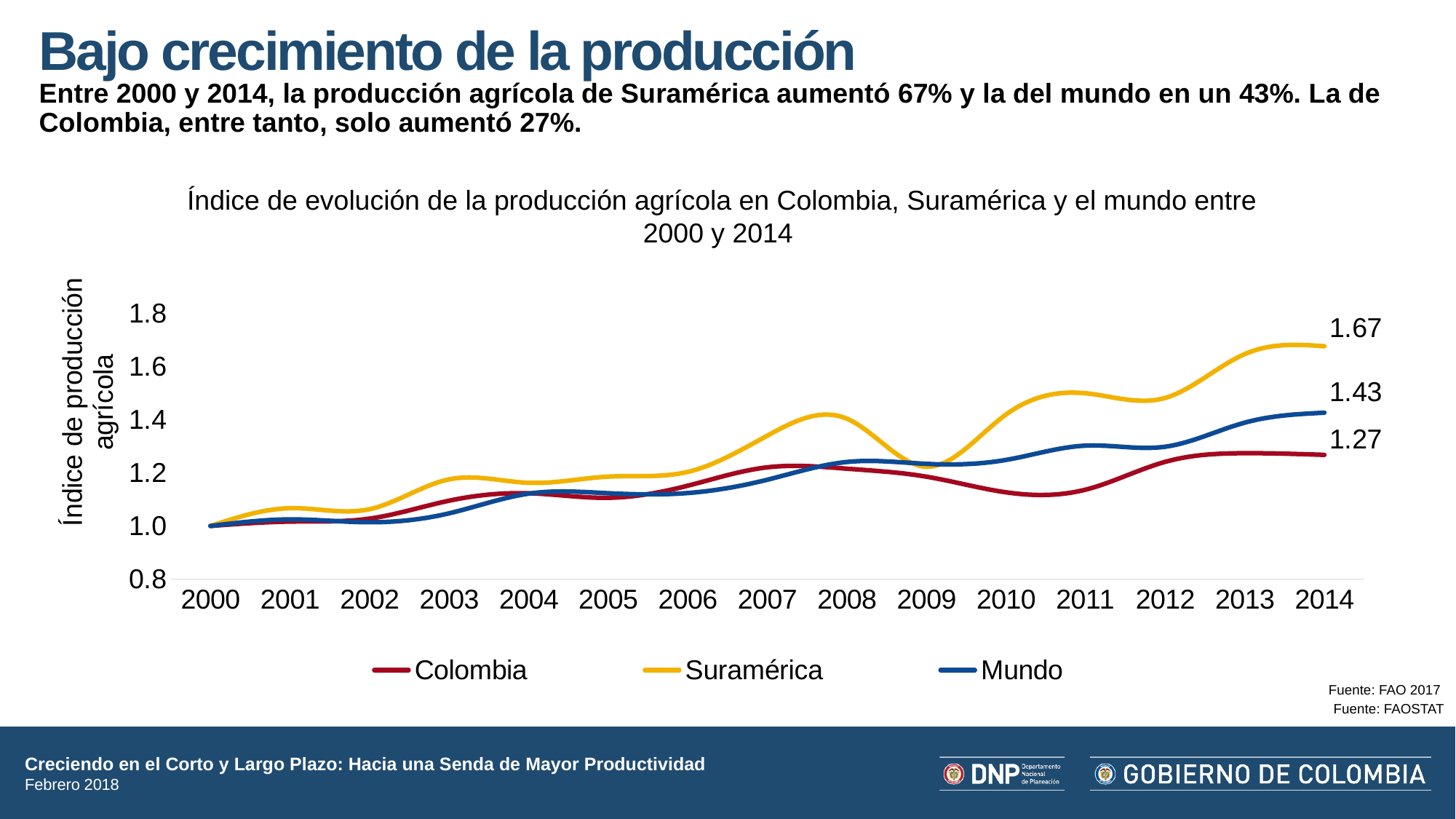
What type of chart is shown on the slide? line chart What is the value for Colombia in 2014? 1.27 What is the difference between the 2014 values for Suramérica and Colombia? 0.40 Does the Suramérica series generally rise or fall from 2000 to 2014? rise What is the value for Mundo in 2014? 1.43 How many years are shown on the x axis? 15 Is the value for Suramérica in 2008 greater or less than 1.2? greater Which is larger in 2014, the value for Mundo or the value for Colombia? Mundo How many series does the legend list? 3 What is the value for Suramérica in 2014? 1.67 Which series has the lowest value in 2014? Colombia Which series has the highest value in 2014? Suramérica